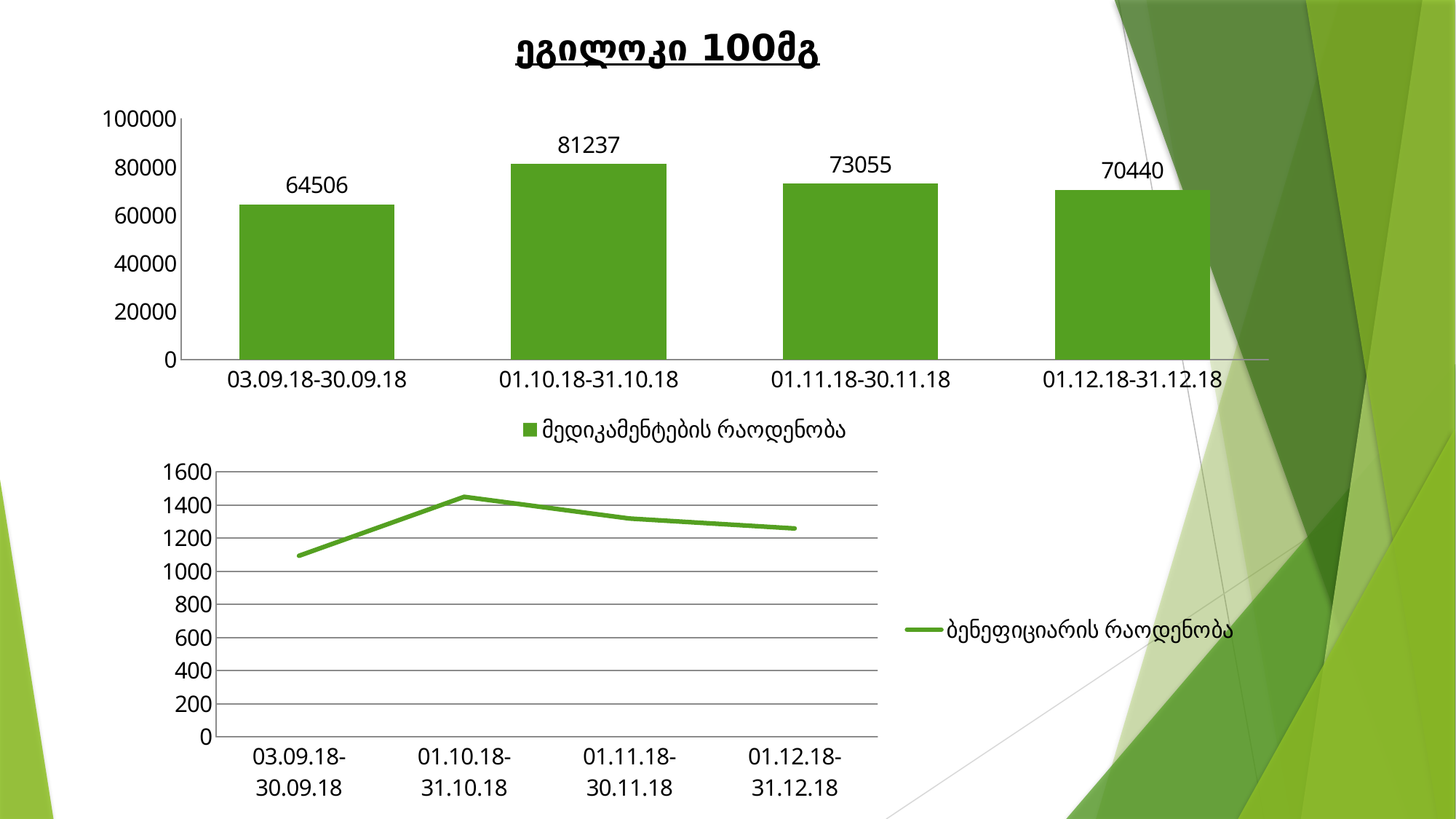
In the bottom line chart, is the value for 01.10.18-31.10.18 greater or less than 1400? greater What type of chart is the top chart on the slide? bar chart In the top bar chart, which period has the highest value? 01.10.18-31.10.18 In the top bar chart, which is larger: the value for 01.11.18-30.11.18 or for 01.12.18-31.12.18? 01.11.18-30.11.18 In the bottom line chart, which period has the highest value? 01.10.18-31.10.18 What type of chart is the bottom chart on the slide? line chart In the top bar chart, which period has the lowest value? 03.09.18-30.09.18 In the top bar chart, what is the difference between the values for 01.10.18-31.10.18 and 01.11.18-30.11.18? 8182 How many bars are in the top bar chart? 4 In the bottom line chart, is the value for 03.09.18-30.09.18 greater or less than 1200? less In the top bar chart, what is the value for 03.09.18-30.09.18? 64506 In the top bar chart, what is the value for 01.10.18-31.10.18? 81237